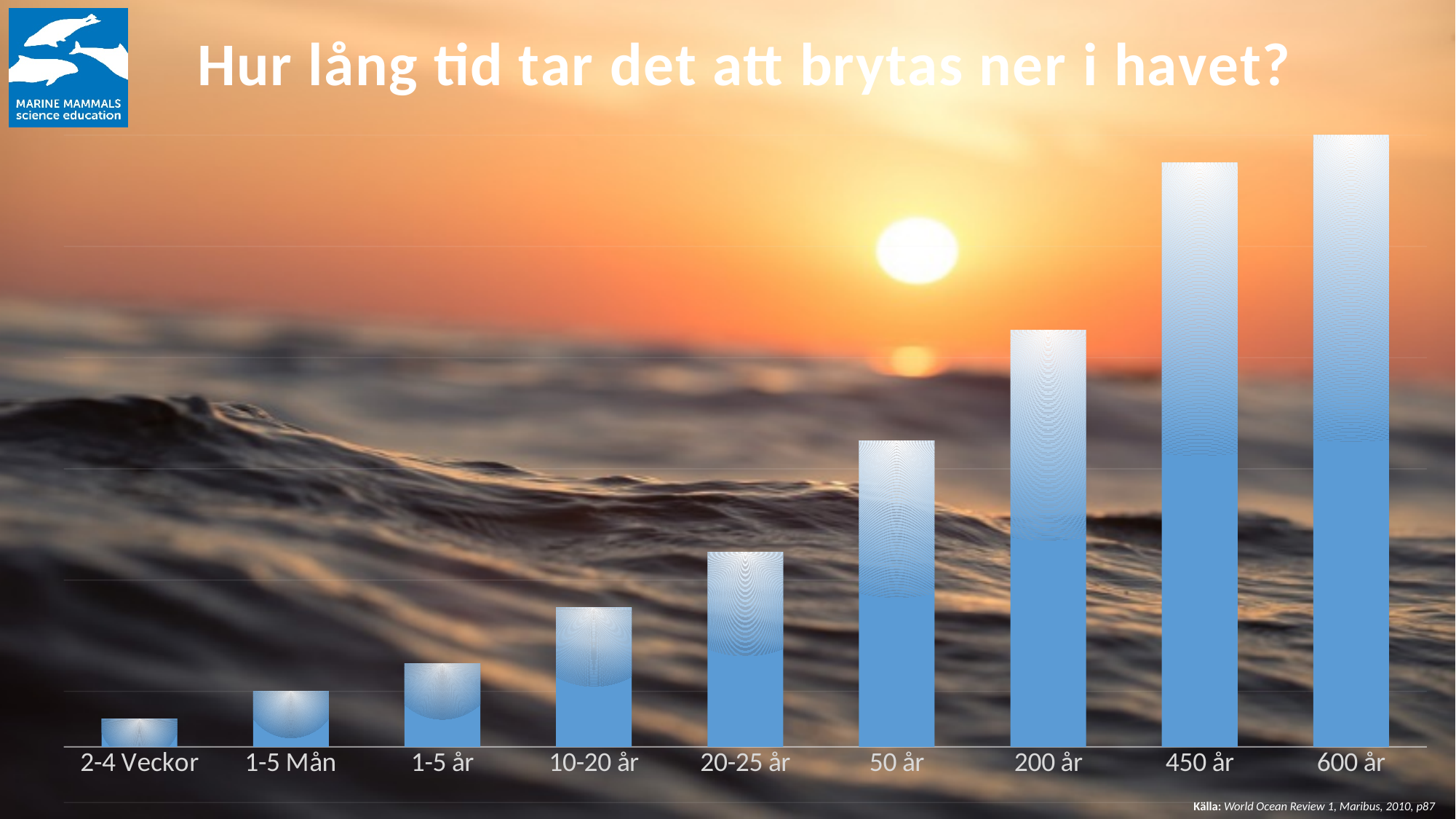
What is the title of the chart? Hur lång tid tar det att brytas ner i havet? What colour are the bars in the chart? blue What kind of chart is shown on the slide? bar chart Which bar is taller, 50 år or 200 år? 200 år Which bar is shorter, 10-20 år or 20-25 år? 10-20 år Which category has the shortest bar? 2-4 Veckor What is the label of the first category on the x axis? 2-4 Veckor Do the bars rise or fall from left to right along the x axis? rise What is the label of the category between 200 år and 600 år? 450 år Which category has the tallest bar? 600 år Which bar is taller, 1-5 Mån or 1-5 år? 1-5 år How many bars does the chart show? 9